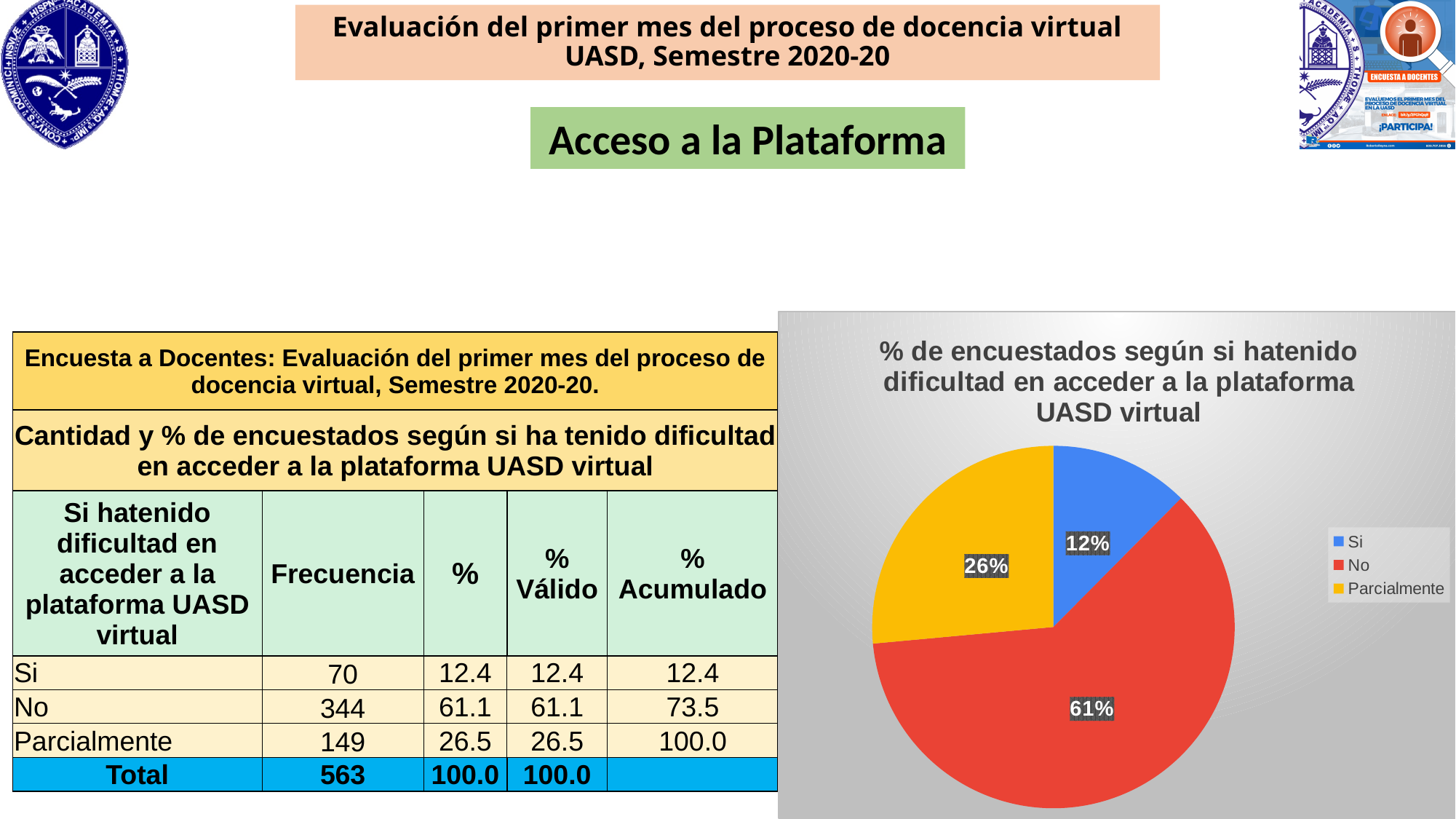
What colour is the 'No' slice in the pie chart? red What percentage does the 'Si' slice show in the pie chart? 12% What is the title of the pie chart? % de encuestados según si hatenido dificultad en acceder a la plataforma UASD virtual How many slices does the pie chart have? 3 What percentage does the 'No' slice show in the pie chart? 61% What percentage does the 'Parcialmente' slice show in the pie chart? 26% Which slice is larger in the pie chart, 'Parcialmente' or 'Si'? Parcialmente How many entries does the legend of the pie chart list? 3 Which category has the smallest slice in the pie chart? Si Which category has the largest slice in the pie chart? No What is the difference in percentage points between the 'No' slice and the 'Parcialmente' slice? 35 What kind of chart is shown on the slide? pie chart